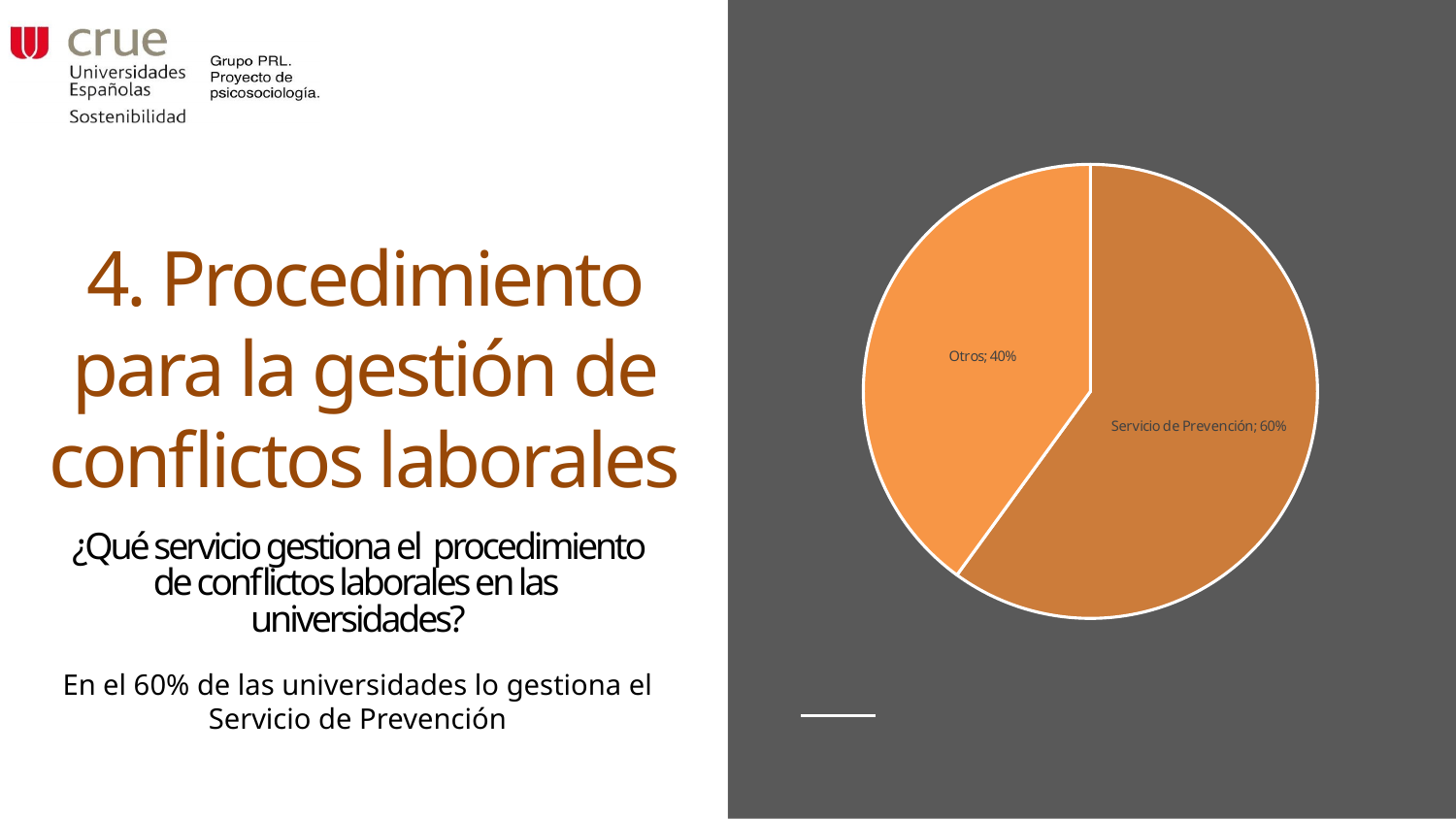
What is the total of the two slices shown in the pie chart? 100% What share of the pie does "Servicio de Prevención" represent? 60% Which slice of the pie is the smallest? Otros What is the difference in percentage points between the "Servicio de Prevención" slice and the "Otros" slice? 20 What kind of chart is shown on the slide? pie chart How many slices does the pie chart have? 2 Is the value for "Servicio de Prevención" greater or less than 50%? greater Is the value for "Otros" greater or less than 50%? less What share of the pie does "Otros" represent? 40% Which slice of the pie is the largest? Servicio de Prevención What question does the slide say the pie chart answers? ¿Qué servicio gestiona el procedimiento de conflictos laborales en las universidades? Which is larger, the "Otros" slice or the "Servicio de Prevención" slice? Servicio de Prevención